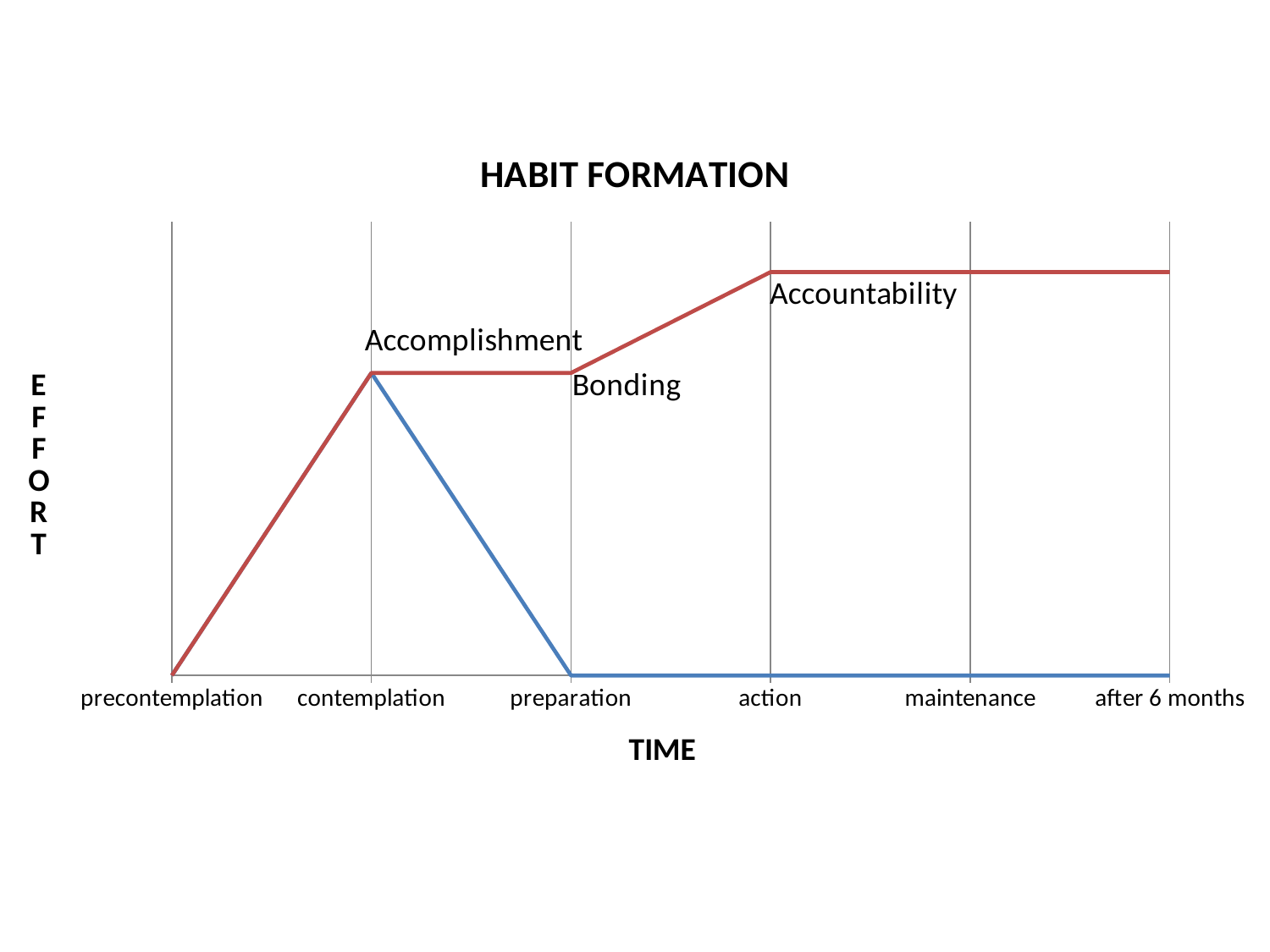
How many categories are shown along the x axis? 6 Does the blue line rise or fall between contemplation and preparation? fall At which x-axis category does the red line reach its lowest point? precontemplation Does the red line rise or fall between precontemplation and contemplation? rise What is the label of the x axis? TIME What is the title of the chart? HABIT FORMATION At the preparation stage, which line is higher, the red line or the blue line? red line How many lines are plotted on the chart? 2 Does the blue line rise, fall, or stay flat between preparation and after 6 months? stay flat What type of chart is shown on the slide? line chart At which x-axis category does the blue line reach its highest point? contemplation